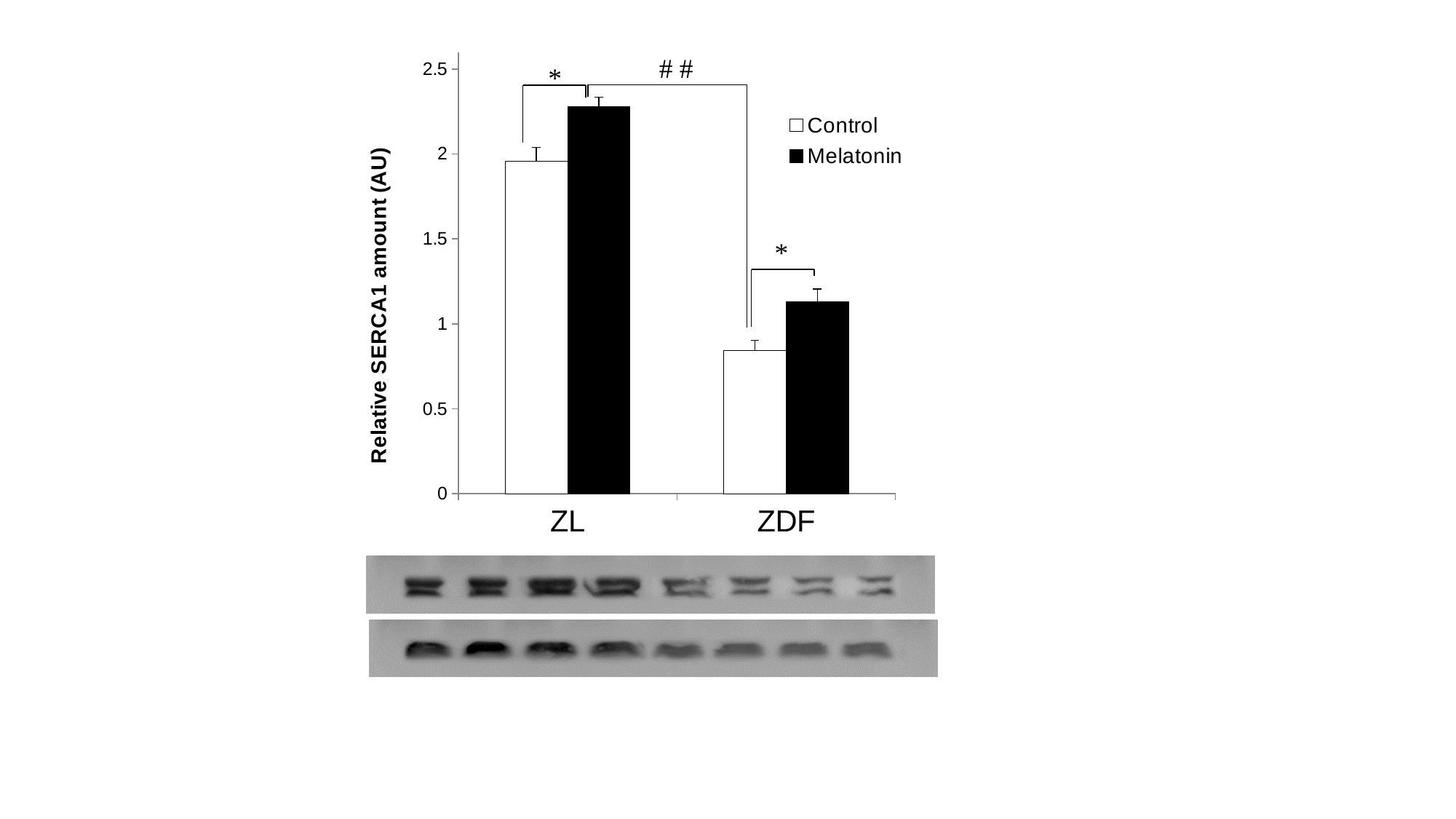
Is the Control value for ZL greater or less than 1.5? greater How many series does the legend list? 2 Which series is shown with black bars? Melatonin What kind of chart is shown on the slide? bar chart What is the label of the y axis? Relative SERCA1 amount (AU) Is the Melatonin value for ZL greater or less than 2? greater Is the Control value for ZDF greater or less than 1? less Which category has the highest Control value? ZL How many categories are shown on the x axis? 2 For ZDF, which is larger, the Control value or the Melatonin value? Melatonin Which bar is the lowest on the chart? ZDF Control